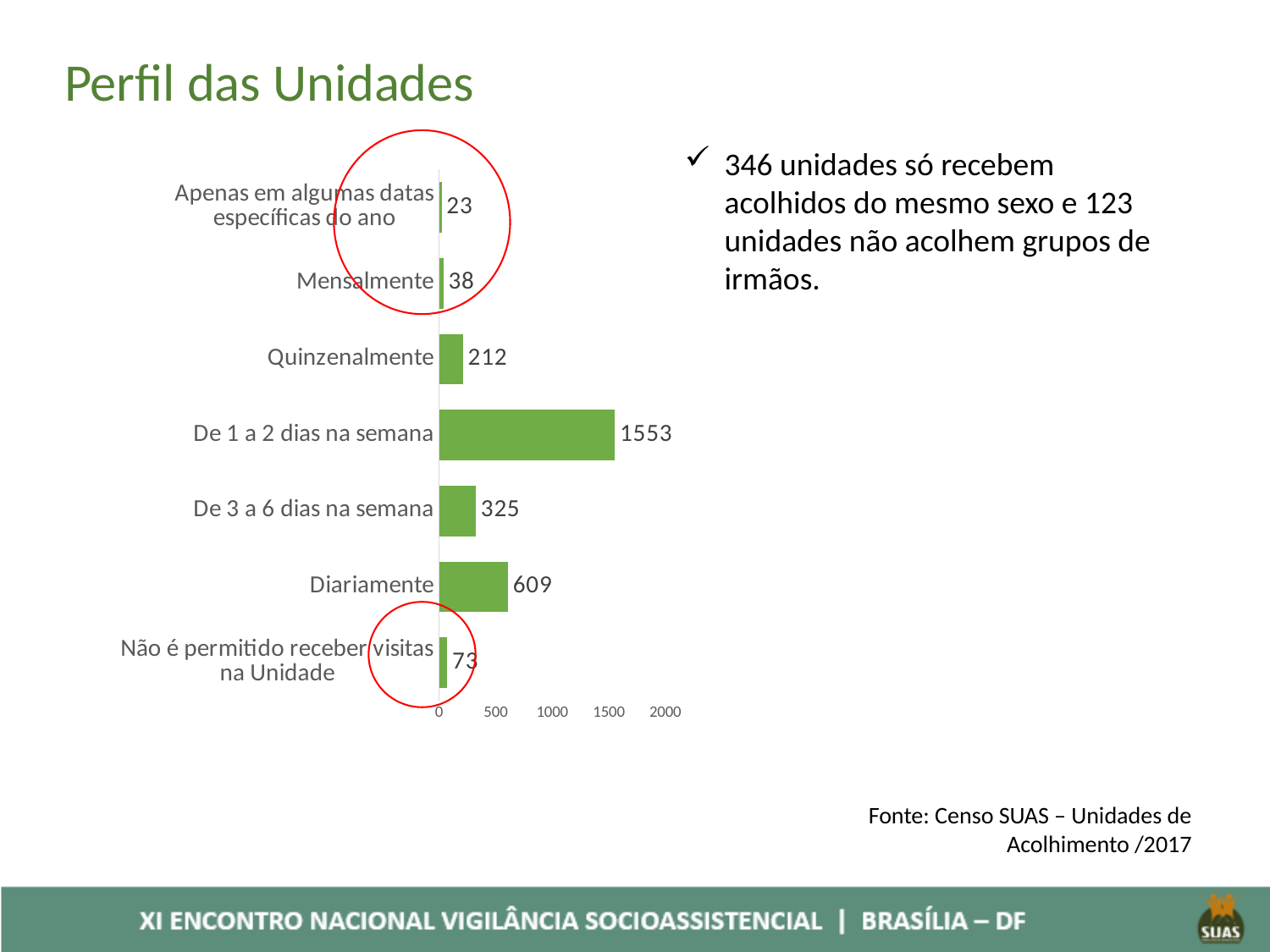
What kind of chart is shown on the slide? bar chart What is the difference between the values for "Diariamente" and "De 3 a 6 dias na semana"? 284 How many categories are shown in the chart? 7 What is the value for "De 1 a 2 dias na semana"? 1553 Is the value for "De 1 a 2 dias na semana" greater or less than 1500? greater What is the value for "Não é permitido receber visitas na Unidade"? 73 Which category has the highest value? De 1 a 2 dias na semana Which is larger, the value for "Quinzenalmente" or the value for "De 3 a 6 dias na semana"? De 3 a 6 dias na semana Which category has the lowest value? Apenas em algumas datas específicas do ano What is the highest tick value shown on the horizontal axis? 2000 What is the value for "Mensalmente"? 38 What is the value for "Diariamente"? 609